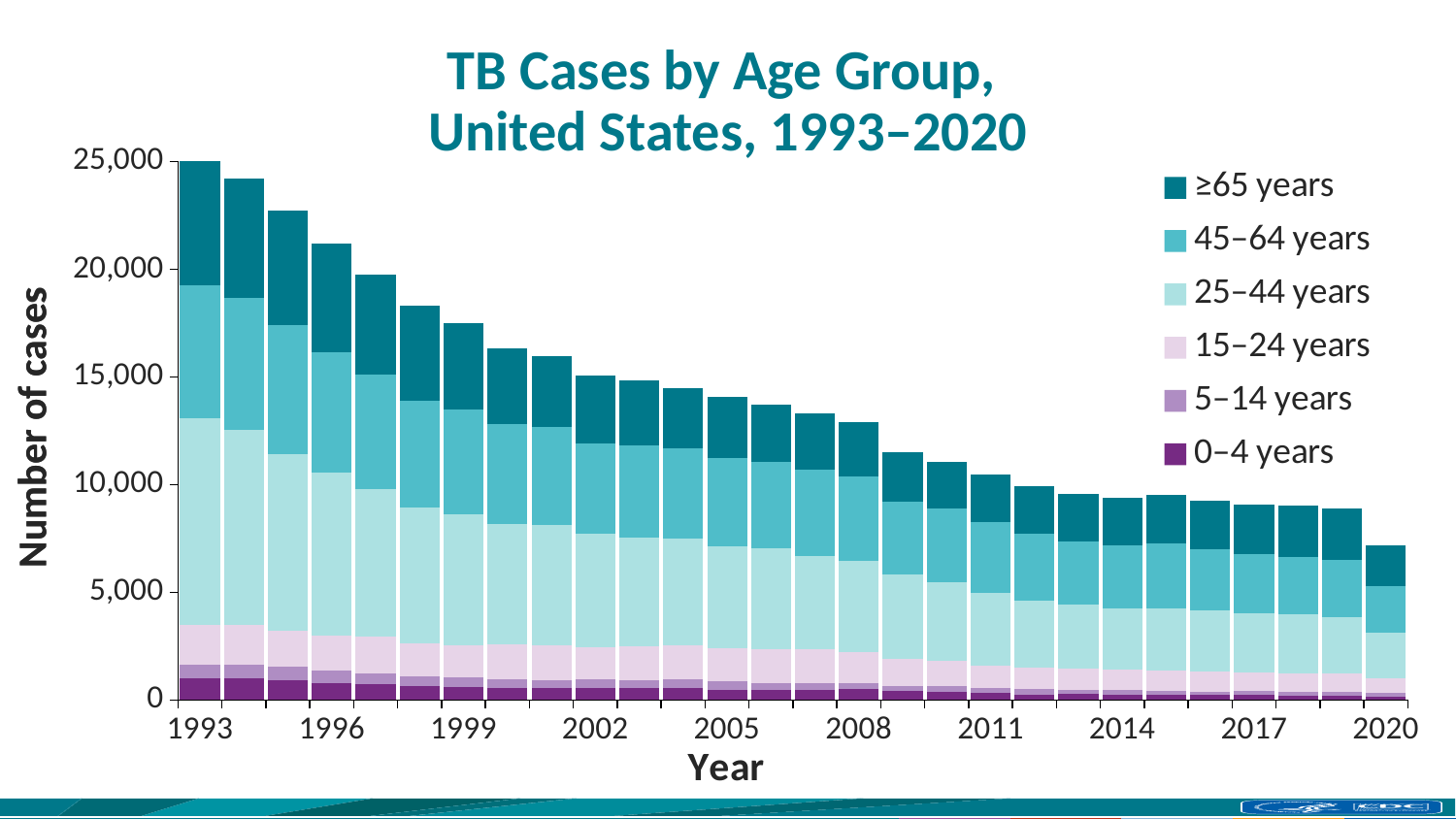
Which year has more total TB cases, 1996 or 2011? 1996 Is the total number of cases in 2020 greater or less than 10,000? less Is the total number of cases in 1993 greater or less than 20,000? greater Is the total number of cases in 2008 greater or less than 10,000? greater Which age group is listed first (at the top) in the legend? ≥65 years What kind of chart is shown on the slide? Stacked bar chart Which year has the highest total number of TB cases? 1993 How many years (bars) are plotted in the chart? 28 What is the title of the chart? TB Cases by Age Group, United States, 1993–2020 Which year has the lowest total number of TB cases? 2020 How many age-group series does the legend list? 6 Do the total TB cases generally rise or fall from 1993 to 2020? Fall